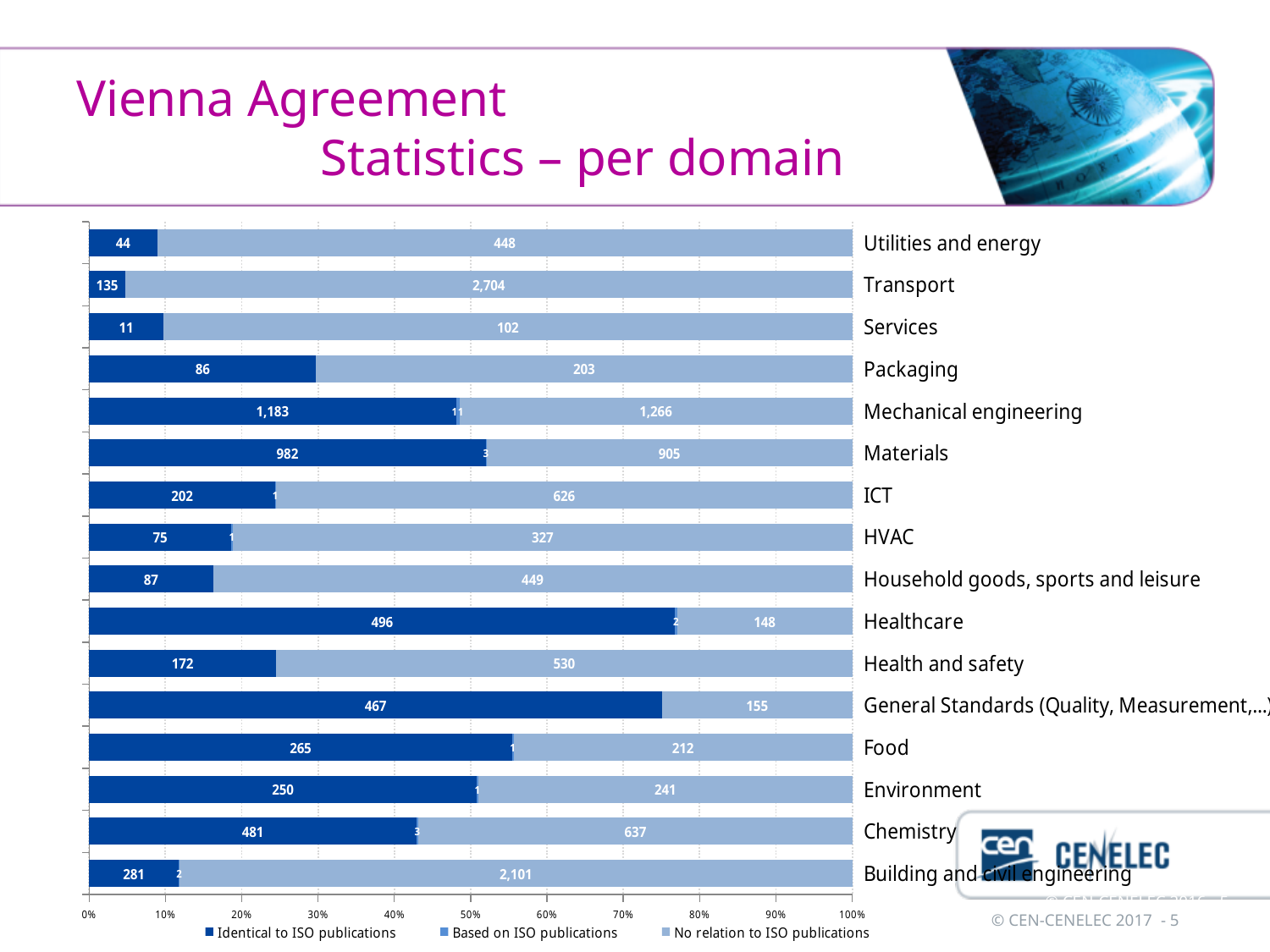
What is the 'No relation to ISO publications' value for Healthcare? 148 Is the share of the Healthcare bar taken by 'Identical to ISO publications' greater or less than 70%? greater What is the 'No relation to ISO publications' value for Transport? 2,704 How many domains are shown in the chart? 16 Which domain has the lowest 'Identical to ISO publications' value? Services What is the total of the printed values in the Packaging bar? 289 What is the 'Identical to ISO publications' value for Mechanical engineering? 1,183 What kind of chart is shown on the slide? Stacked bar chart Which has a larger 'Identical to ISO publications' value, Chemistry or Building and civil engineering? Chemistry How many series does the legend list? 3 For Materials, what is the difference between the 'Identical to ISO publications' value and the 'No relation to ISO publications' value? 77 Which domain has the highest 'Identical to ISO publications' value? Mechanical engineering